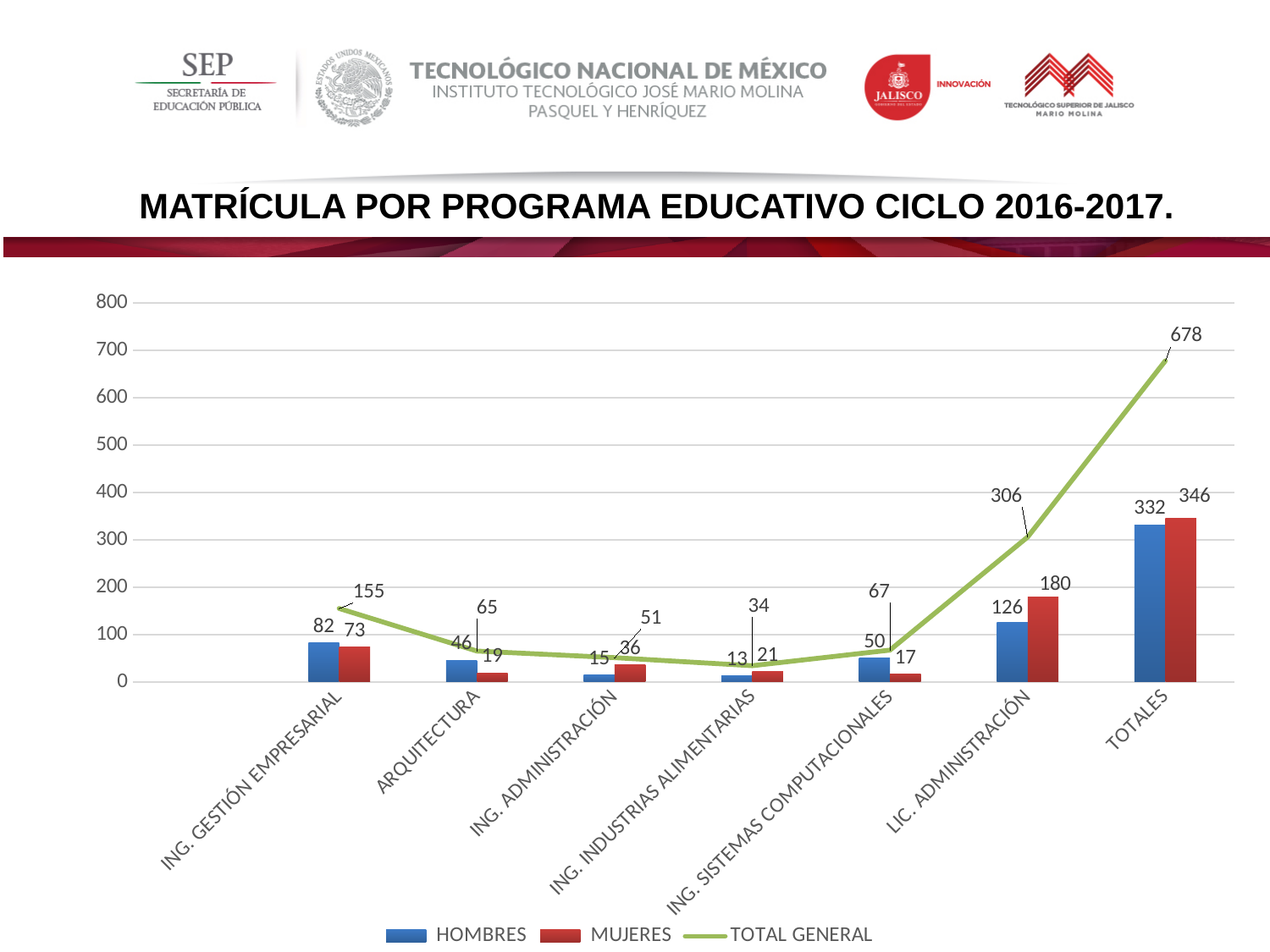
What is the MUJERES value for LIC. ADMINISTRACIÓN? 180 What is the HOMBRES value for ING. GESTIÓN EMPRESARIAL? 82 What is the title of the chart? MATRÍCULA POR PROGRAMA EDUCATIVO CICLO 2016-2017. What is the TOTAL GENERAL value for ARQUITECTURA? 65 What kind of chart is shown on the slide? Combined bar and line chart For ING. SISTEMAS COMPUTACIONALES, which is larger, HOMBRES or MUJERES? HOMBRES How many categories are shown on the x axis? 7 Which category has the lowest TOTAL GENERAL value? ING. INDUSTRIAS ALIMENTARIAS What is the difference between the MUJERES and HOMBRES values for LIC. ADMINISTRACIÓN? 54 Is the TOTAL GENERAL value for TOTALES greater or less than 600? greater Excluding TOTALES, which category has the highest TOTAL GENERAL value? LIC. ADMINISTRACIÓN How many series does the legend list? 3